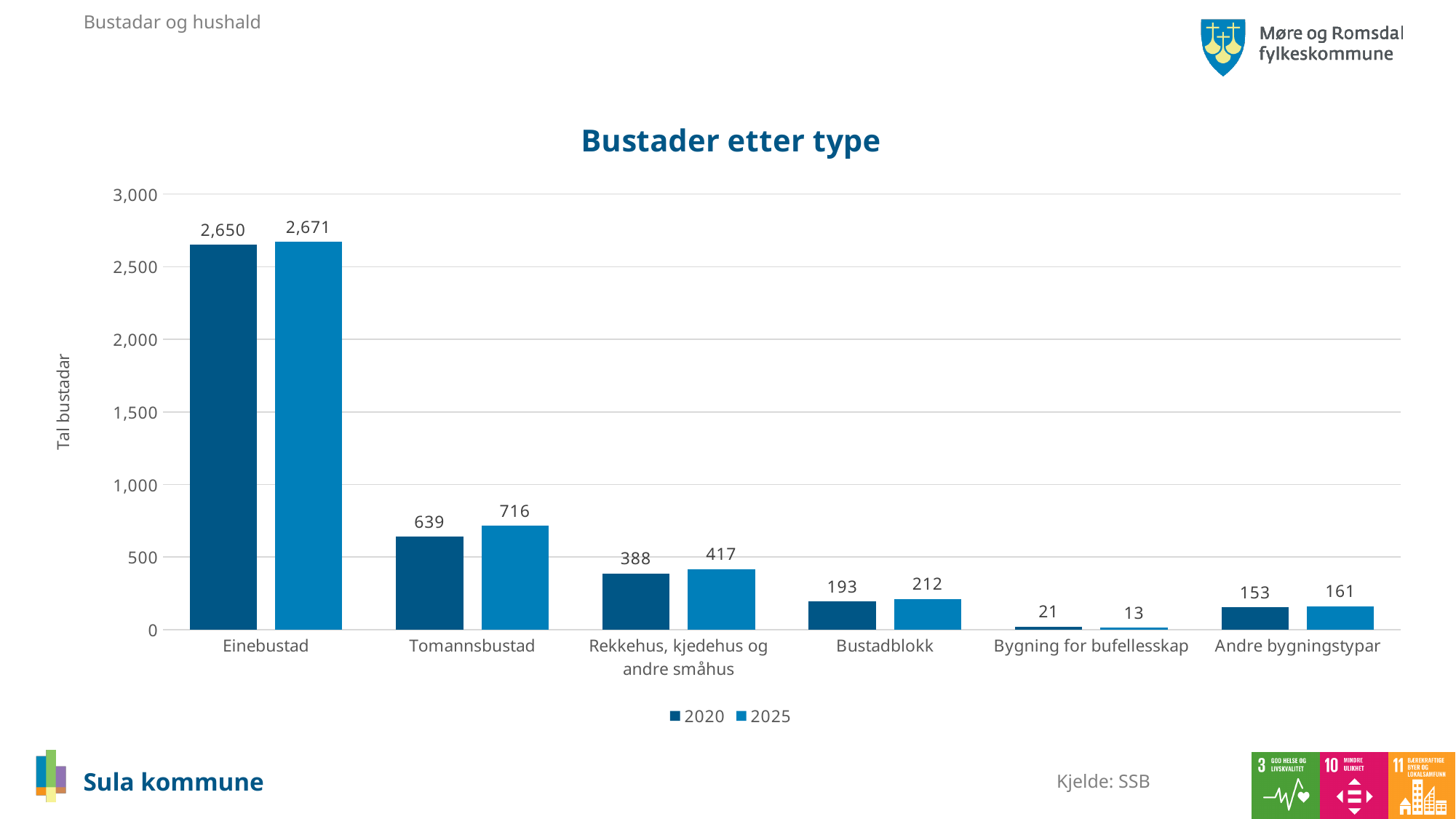
What is the value for Bygning for bufellesskap in 2025? 13 Which category has the lowest value in 2025? Bygning for bufellesskap How many series does the legend list? 2 What kind of chart is shown? bar chart How many categories are shown on the x axis? 6 Which is larger for Bygning for bufellesskap: the 2020 value or the 2025 value? 2020 What is the difference between the 2025 and 2020 values for Tomannsbustad? 77 What is the value for Tomannsbustad in 2020? 639 What is the title of the chart? Bustader etter type What is the value for Einebustad in 2025? 2,671 Which category has the highest value in 2020? Einebustad Is the 2020 value for Rekkehus, kjedehus og andre småhus greater or less than 500? less